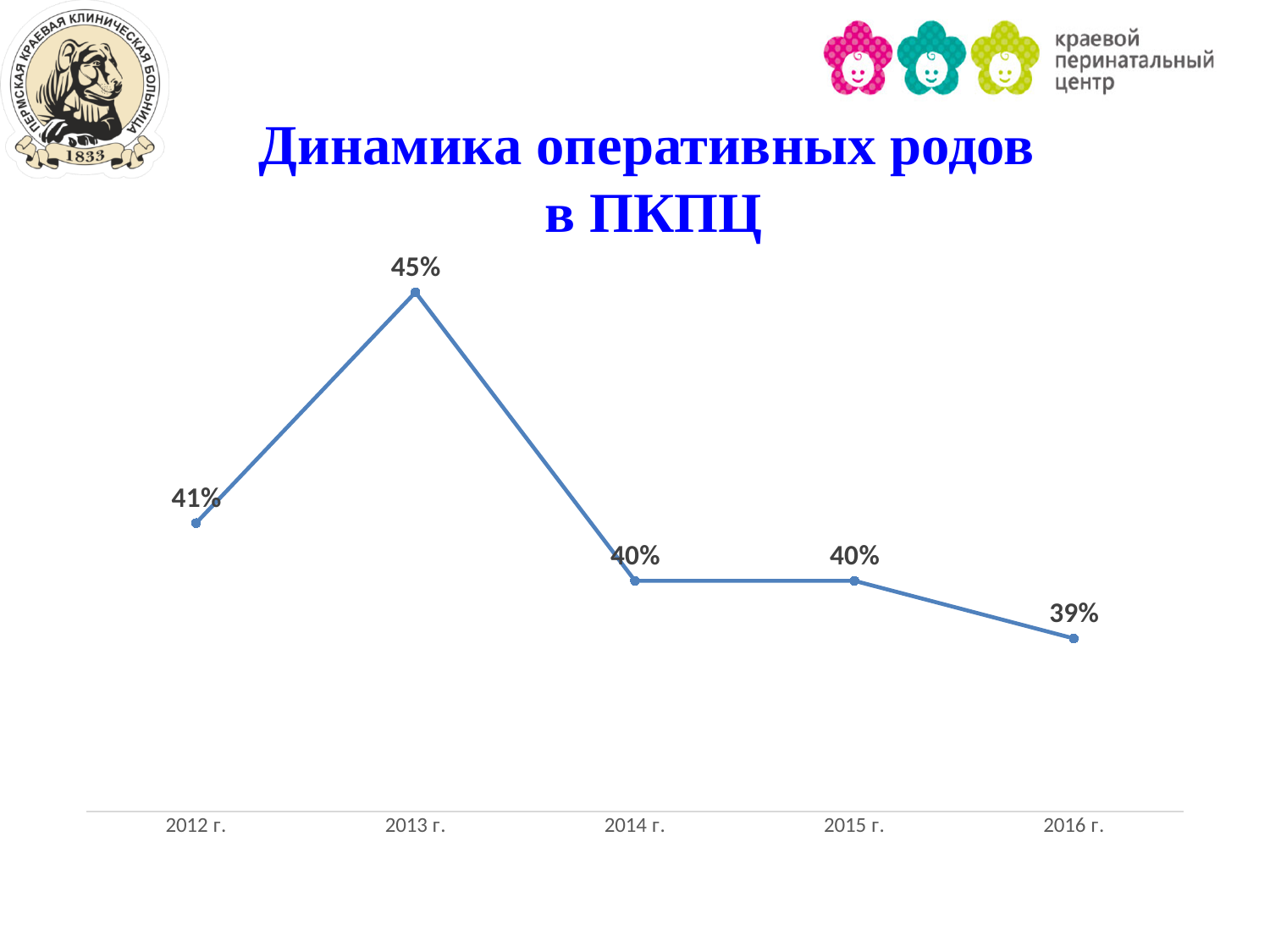
Which year has the lowest value? 2016 г. What is the difference between the values for 2012 г. and 2013 г.? 4% What kind of chart is shown on the slide? line chart Which is larger, the value for 2012 г. or the value for 2014 г.? 2012 г. What is the value for 2016 г.? 39% Do the values rise or fall from 2013 г. to 2016 г.? fall How many years are plotted on the chart? 5 What is the title of the chart? Динамика оперативных родов в ПКПЦ What is the difference between the values for 2013 г. and 2016 г.? 6% What is the value for 2013 г.? 45% Which year has the highest value? 2013 г. What is the value for 2012 г.? 41%